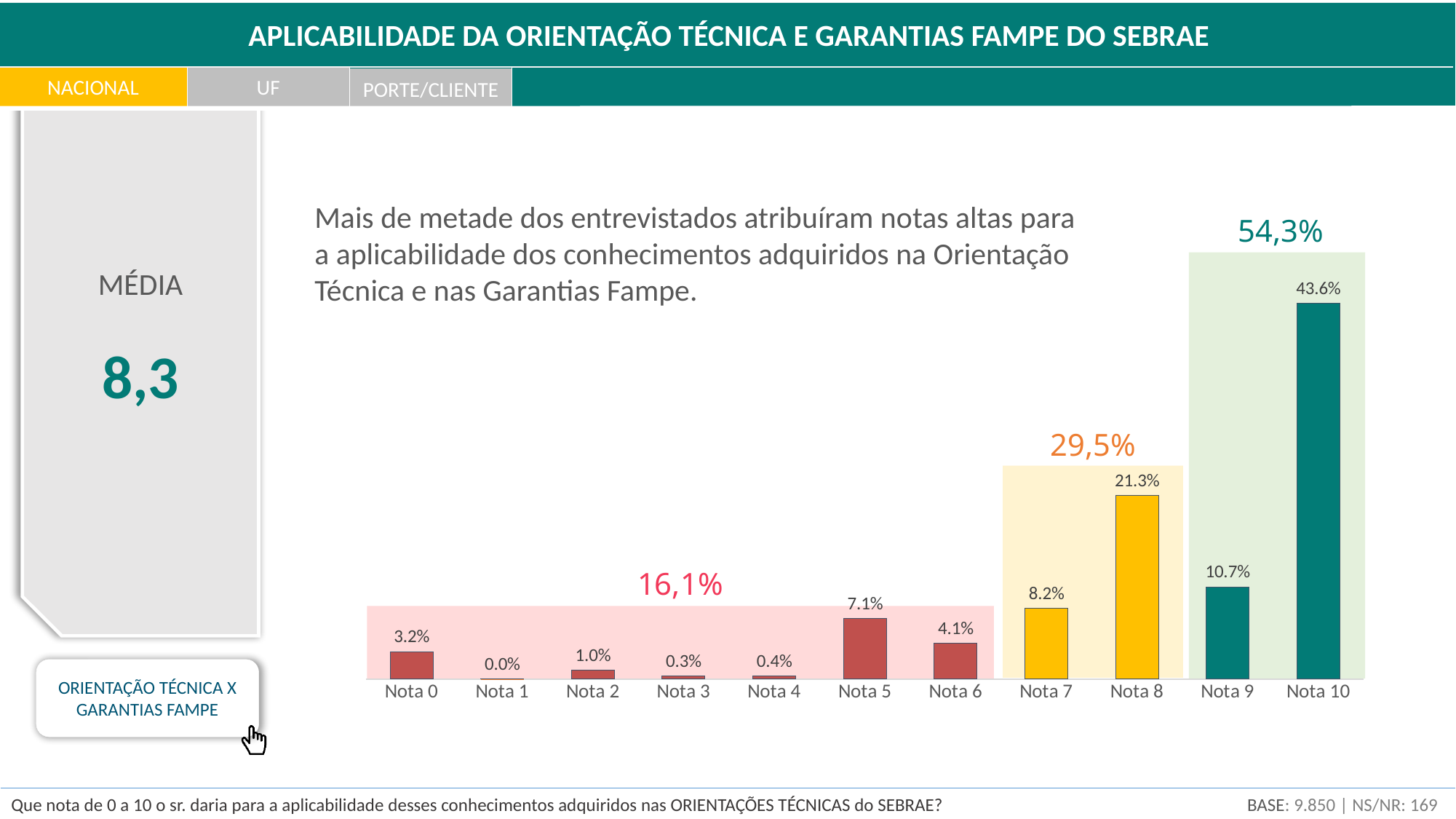
How many categories are shown on the x axis? 11 Which category has the highest value? Nota 10 Which is larger, the value for Nota 9 or the value for Nota 7? Nota 9 What is the difference between the values for Nota 10 and Nota 8? 22.3% What is the value for Nota 5? 7.1% What is the average (MÉDIA) score shown on the slide? 8,3 What is the combined share shown for the group Nota 9 and Nota 10? 54,3% Which category has the lowest value? Nota 1 What is the value for Nota 8? 21.3% What kind of chart is shown? bar chart What is the combined share shown for the group Nota 7 and Nota 8? 29,5% What is the value for Nota 10? 43.6%